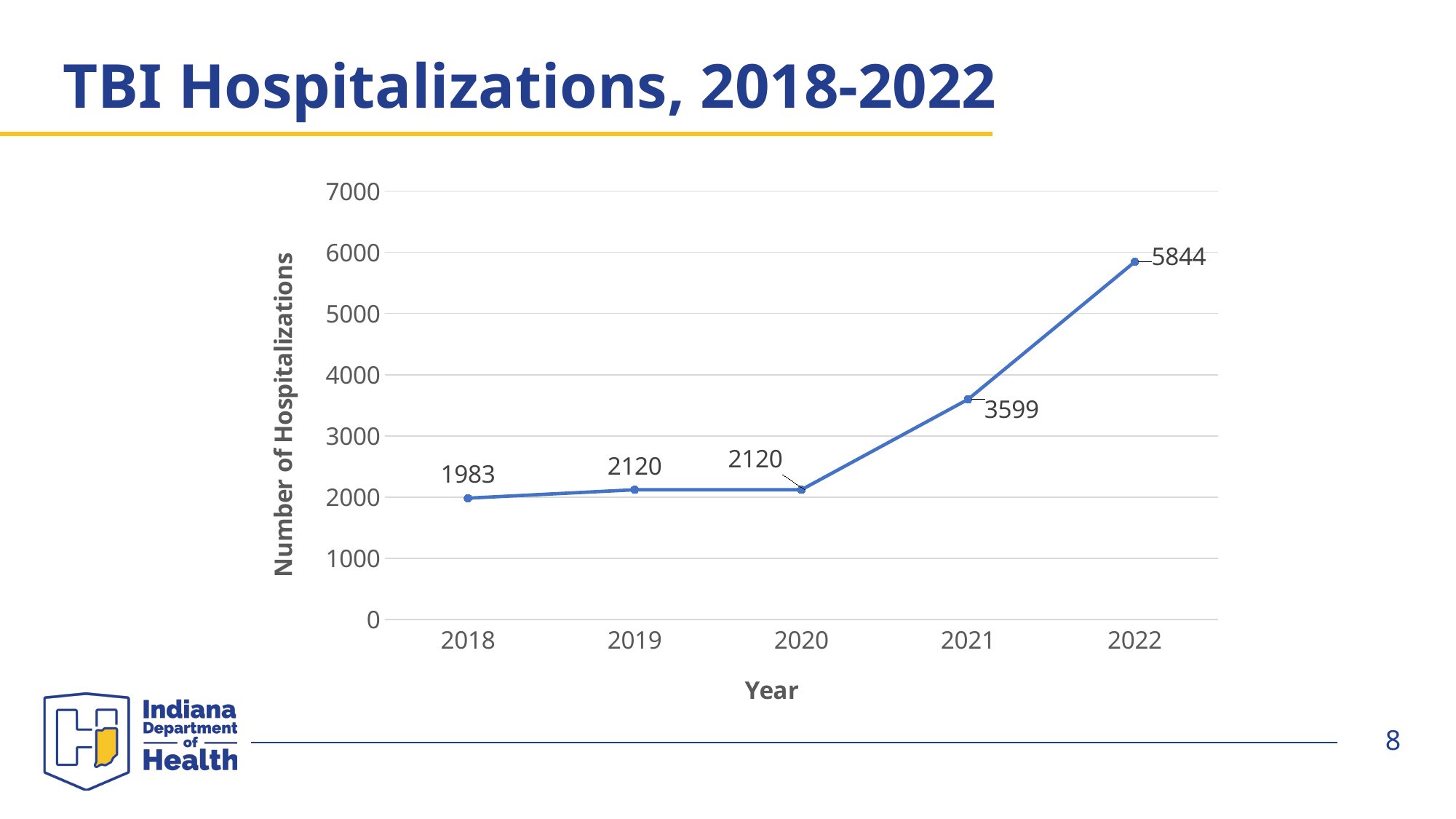
What is the difference in hospitalizations between 2022 and 2021? 2245 What is the number of TBI hospitalizations in 2021? 3599 Which year has the highest number of TBI hospitalizations? 2022 What is the number of TBI hospitalizations in 2018? 1983 Is the value for 2021 greater or less than 3000? greater How many years are plotted on the chart? 5 What is the number of TBI hospitalizations in 2022? 5844 What is the label of the y axis? Number of Hospitalizations Which year had more TBI hospitalizations, 2020 or 2021? 2021 What is the difference in hospitalizations between 2019 and 2018? 137 Which year has the lowest number of TBI hospitalizations? 2018 What kind of chart is shown on the slide? line chart